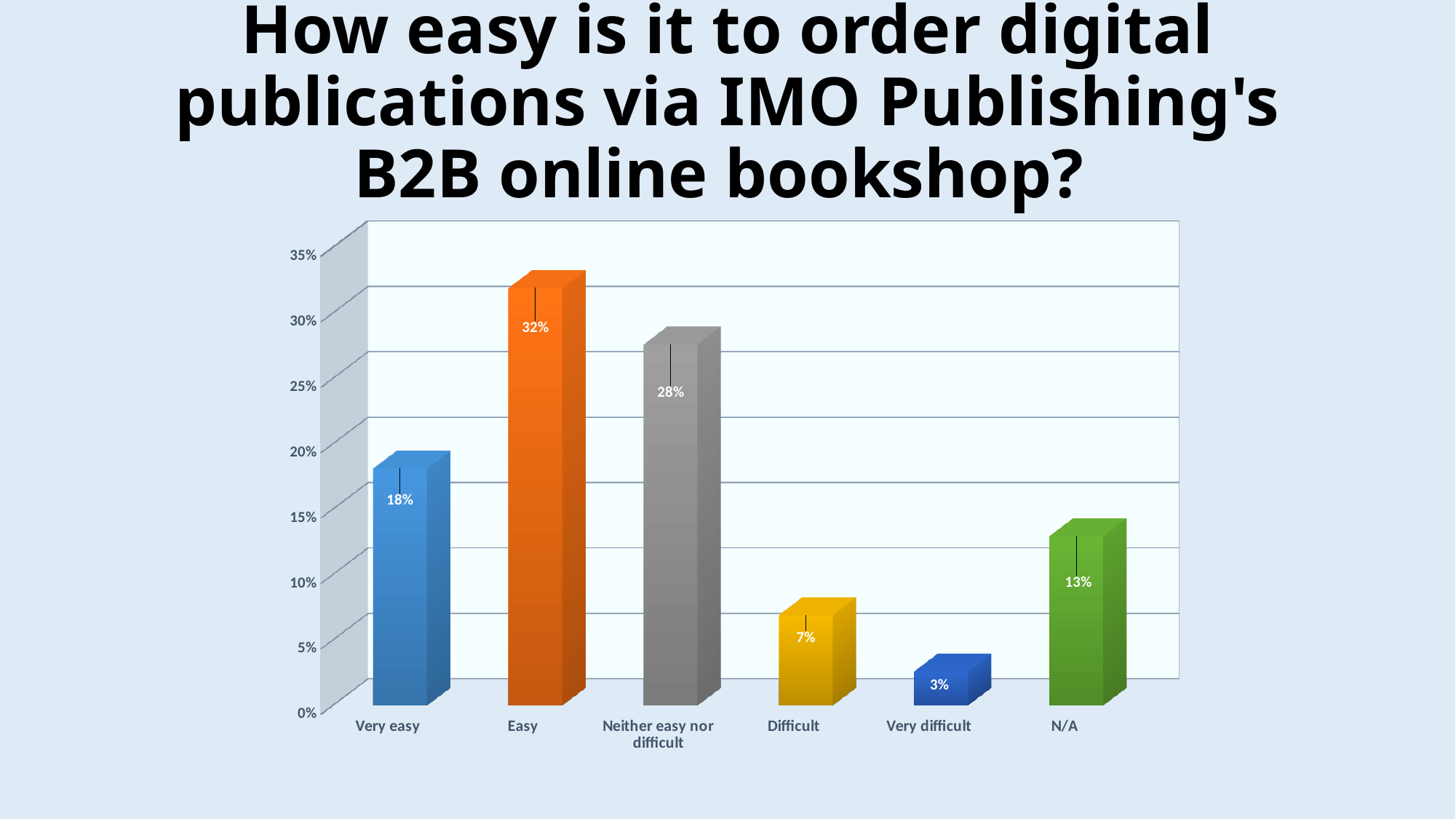
What percentage of respondents said it was "Easy" to order digital publications? 32% What is the value for "N/A"? 13% What kind of chart is shown on the slide? Bar chart Which category has the lowest value? Very difficult What colour is the bar for "Easy"? Orange What is the value for "Very easy"? 18% What is the difference between the values for "Easy" and "Neither easy nor difficult"? 4% Which is larger, the value for "Very easy" or the value for "N/A"? Very easy Which category has the highest value? Easy What is the value for "Very difficult"? 3% How many categories are shown on the x axis? 6 What is the difference between the values for "Very easy" and "Difficult"? 11%